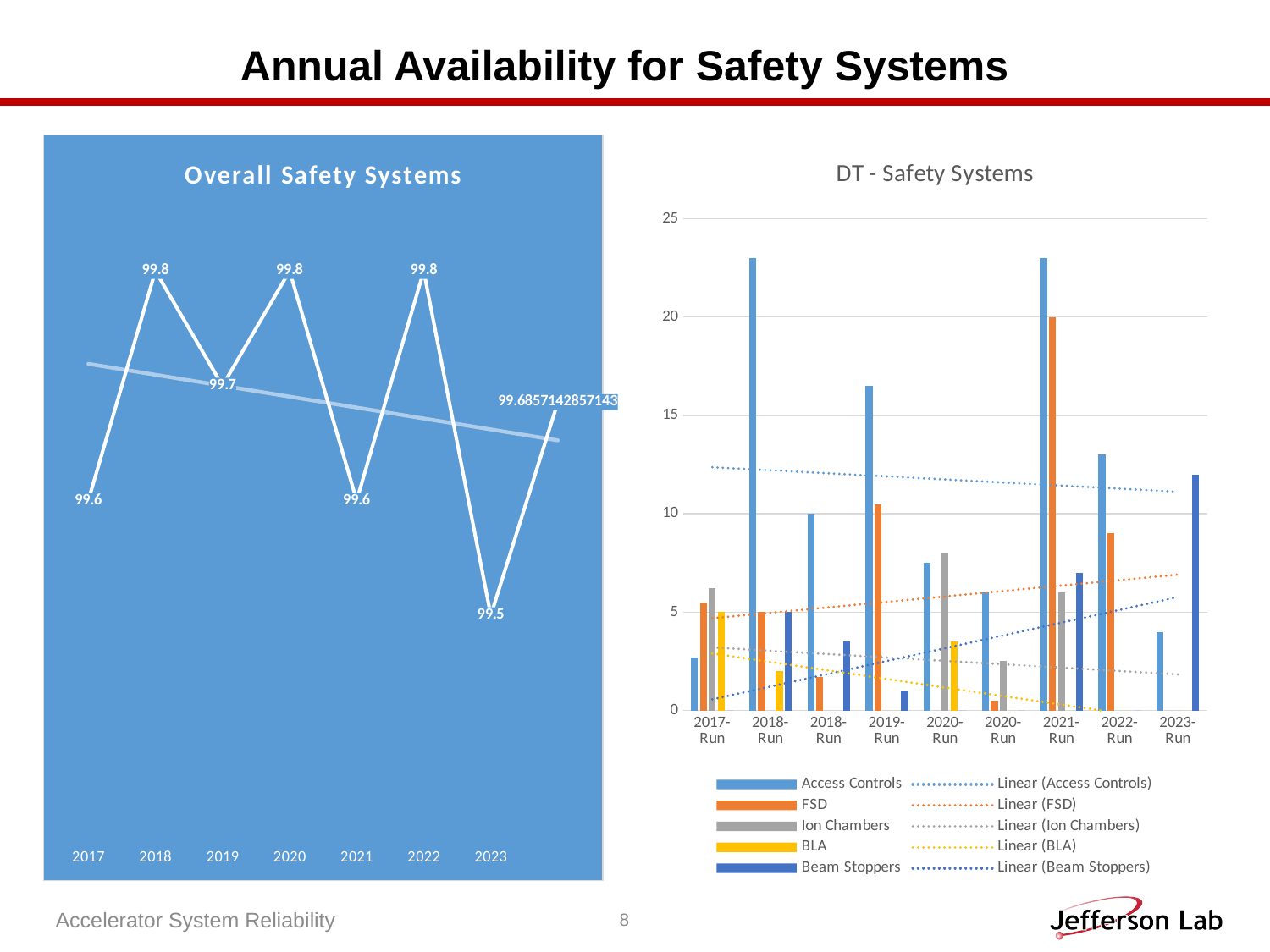
In the DT - Safety Systems chart, is the Access Controls value for 2019-Run greater or less than 15? greater In the Overall Safety Systems chart, what is the value for 2017? 99.6 In the Overall Safety Systems chart, what is the difference between the values for 2018 and 2023? 0.3 What kind of chart is the DT - Safety Systems chart? Bar chart How many categories are shown on the x axis of the DT - Safety Systems chart? 9 How many years are plotted in the Overall Safety Systems chart? 7 In the DT - Safety Systems chart, is the Beam Stoppers value for 2023-Run greater or less than 10? greater In the Overall Safety Systems chart, what is the value for 2023? 99.5 In the Overall Safety Systems chart, which year has the larger value, 2019 or 2021? 2019 In the Overall Safety Systems chart, which year has the lowest value? 2023 In the Overall Safety Systems chart, does the trendline rise or fall from 2017 to 2023? Fall What kind of chart is the Overall Safety Systems chart? Line chart